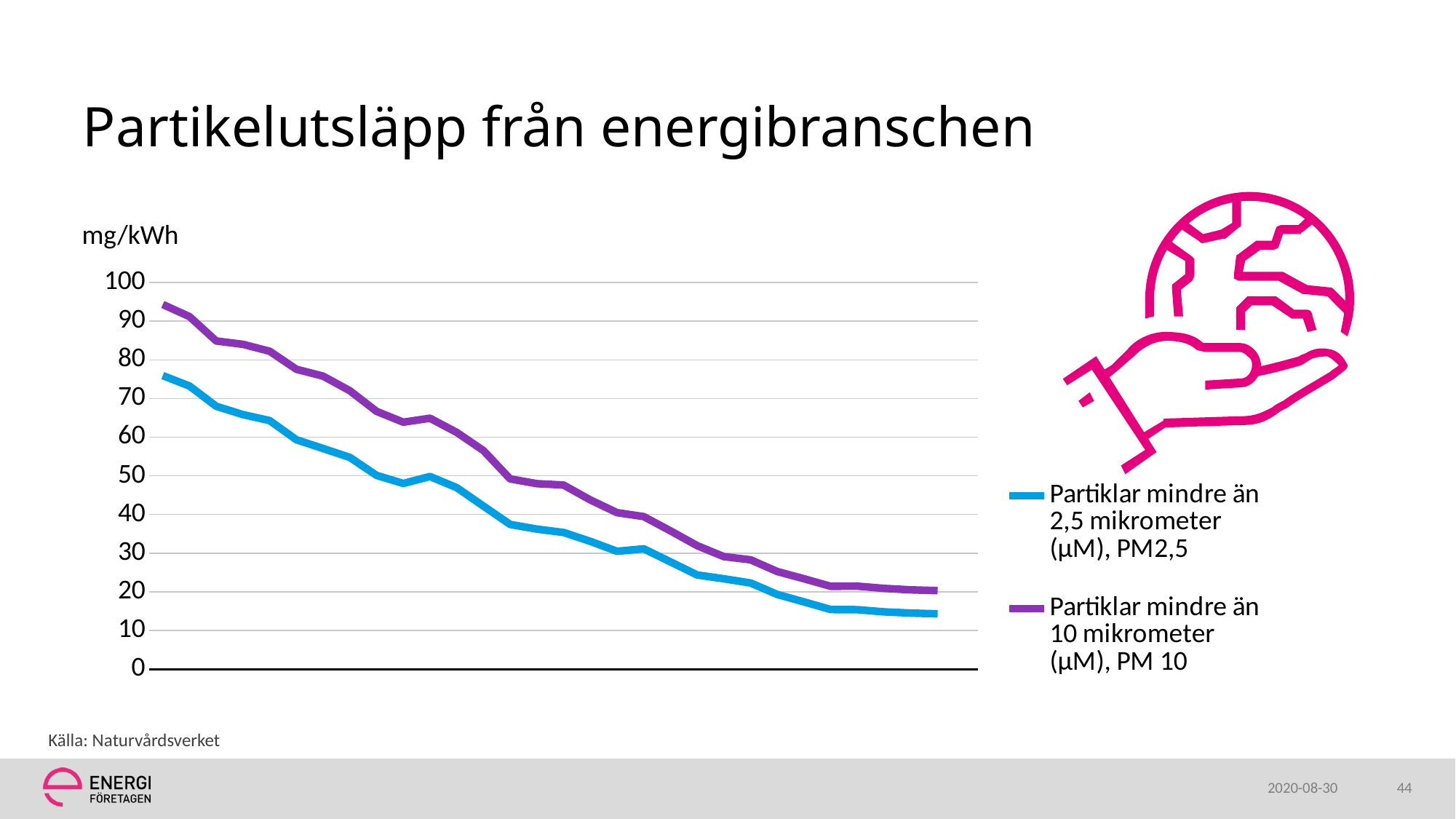
Which series has the higher values throughout the chart, PM2,5 or PM 10? PM 10 How many series does the legend list? 2 Do the values for the PM2,5 series rise or fall along the x axis? fall Is the first value of the PM2,5 series greater or less than 70? greater What kind of chart is shown on the slide? line chart What is the title of the chart? Partikelutsläpp från energibranschen What unit is shown on the vertical axis of the chart? mg/kWh Is the last value of the PM 10 series greater or less than 30? less Is the last value of the PM2,5 series greater or less than 20? less Do the values for the PM 10 series rise or fall along the x axis? fall